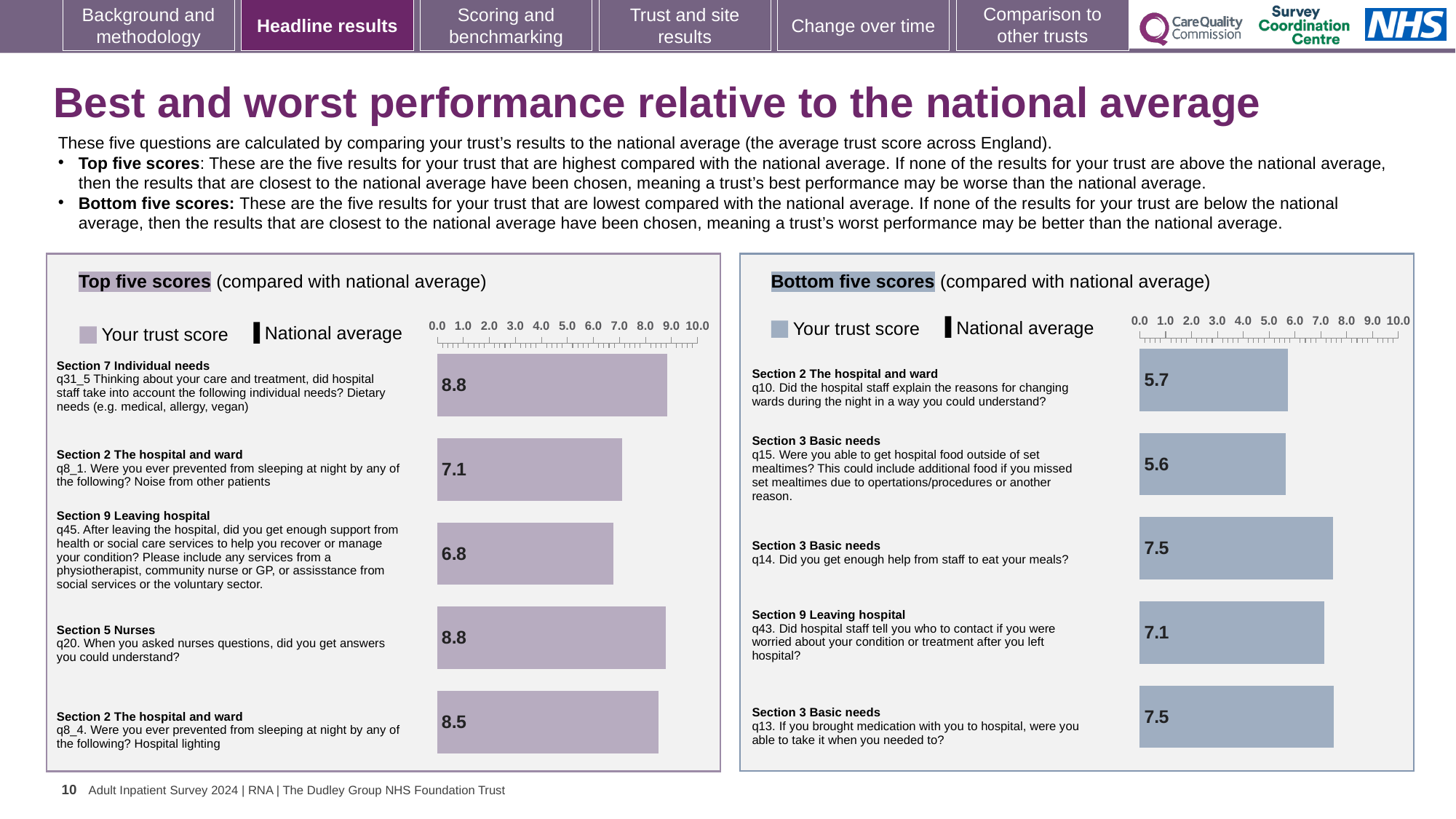
In the Bottom five scores chart, what is the trust score for q43 (told who to contact if worried after leaving hospital)? 7.1 How many entries does the legend of the Bottom five scores chart list? 2 In the Bottom five scores chart, what is the trust score for q10 (staff explaining reasons for changing wards during the night)? 5.7 In the Top five scores chart, what is the trust score for q8_1 (prevented from sleeping by noise from other patients)? 7.1 In the Top five scores chart, what is the difference between the trust score for q31_5 and the trust score for q8_1? 1.7 In the Top five scores chart, which question has the lowest trust score? q45 (Section 9 Leaving hospital) What kind of chart is the Top five scores chart? Bar chart In the Top five scores chart, what is the trust score for q45 (enough support from health or social care services after leaving hospital)? 6.8 In the Top five scores chart, which has the larger trust score: q8_4 (hospital lighting) or q45 (support after leaving hospital)? q8_4 How many questions are shown in the Bottom five scores chart? 5 In the Bottom five scores chart, which question has the lowest trust score? q15 (Section 3 Basic needs) In the Bottom five scores chart, what is the difference between the trust score for q14 and the trust score for q10? 1.8